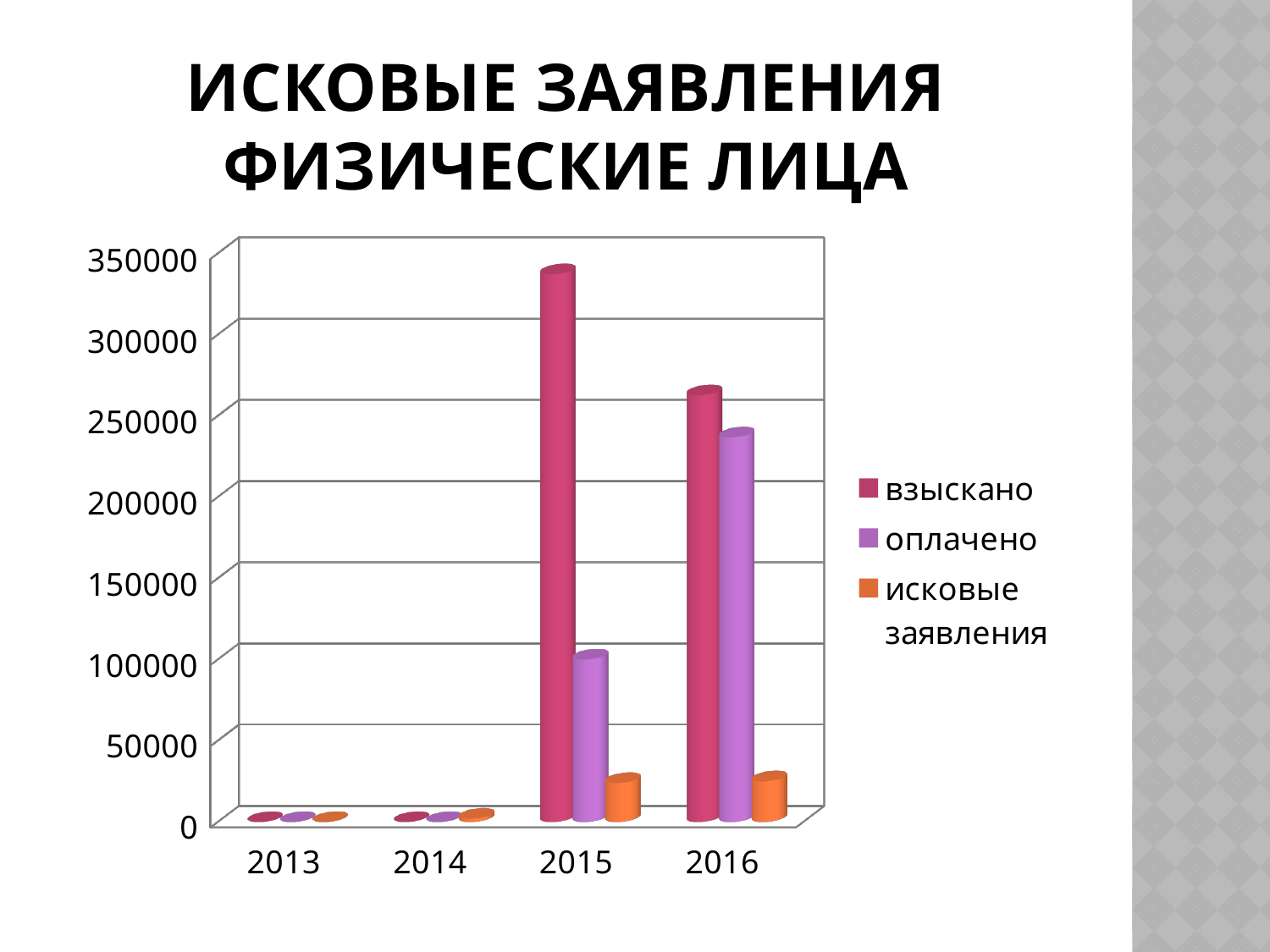
Which series is shown in orange in the chart? исковые заявления How many series does the chart legend list? 3 How many years are shown on the x axis of the chart? 4 In which year is the value for взыскано the highest? 2015 Which is larger: оплачено in 2015 or оплачено in 2016? оплачено in 2016 Is the value for взыскано in 2015 greater or less than 300000? greater Is the value for исковые заявления in 2016 greater or less than 50000? less Is the value for оплачено in 2015 greater or less than 150000? less Which is larger: взыскано in 2015 or взыскано in 2016? взыскано in 2015 What kind of chart is shown on the slide? bar chart What is the title of the slide above the chart? ИСКОВЫЕ ЗАЯВЛЕНИЯ ФИЗИЧЕСКИЕ ЛИЦА